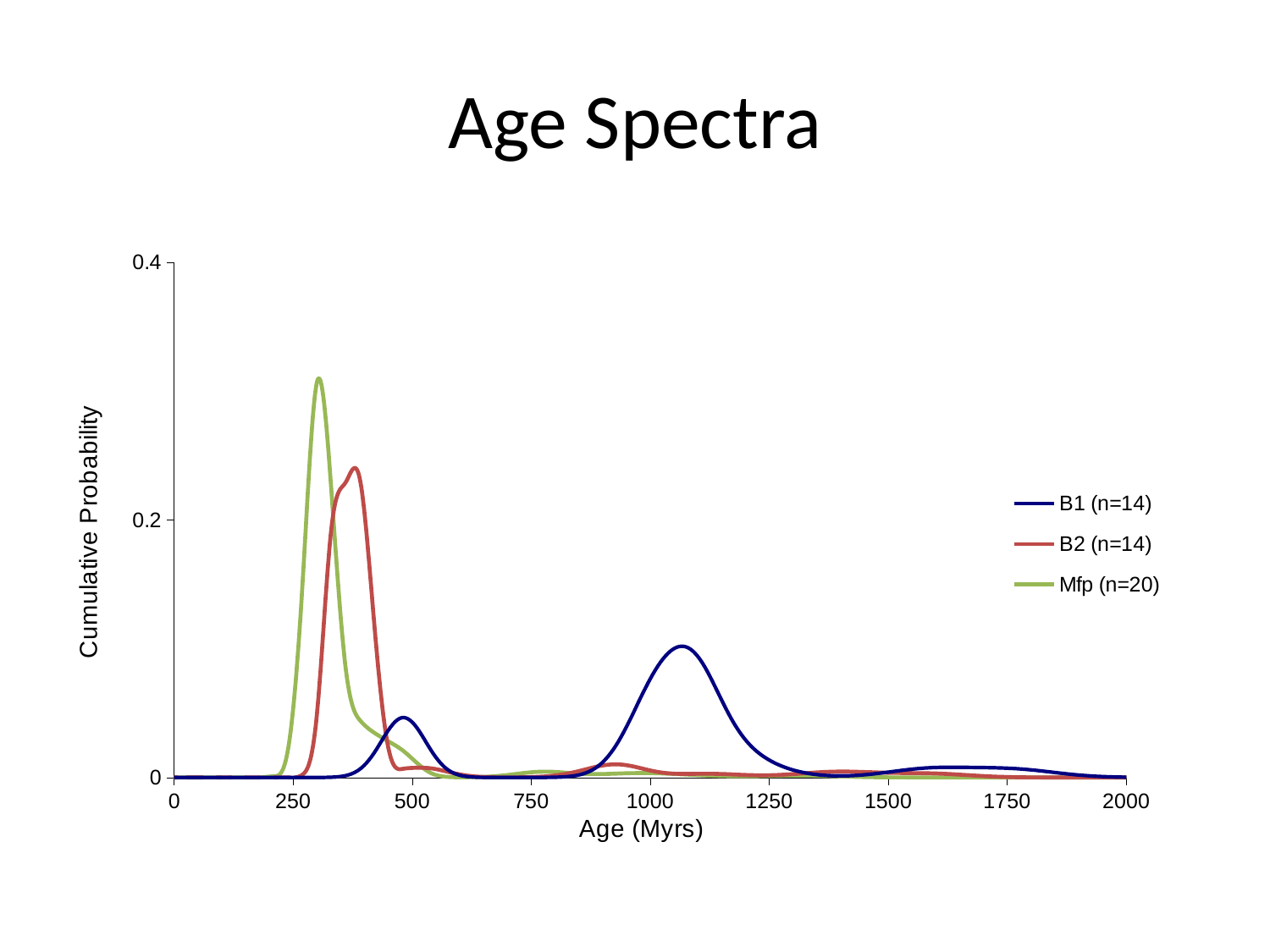
Which series has the higher peak, B1 (n=14) or B2 (n=14)? B2 (n=14) Which series has its largest peak near 1000 Myrs? B1 (n=14) What kind of chart is shown on the slide? line chart How many tick labels are shown on the x axis? 9 How many series does the legend list? 3 What is the title of the chart? Age Spectra Which series reaches the highest peak on the chart? Mfp (n=20) Is the peak value of the Mfp (n=20) series greater or less than 0.2? greater What is the label of the x axis? Age (Myrs) Is the peak value of the B1 (n=14) series greater or less than 0.2? less What is the maximum value shown on the y axis? 0.4 Is the peak value of the B2 (n=14) series greater or less than 0.2? greater